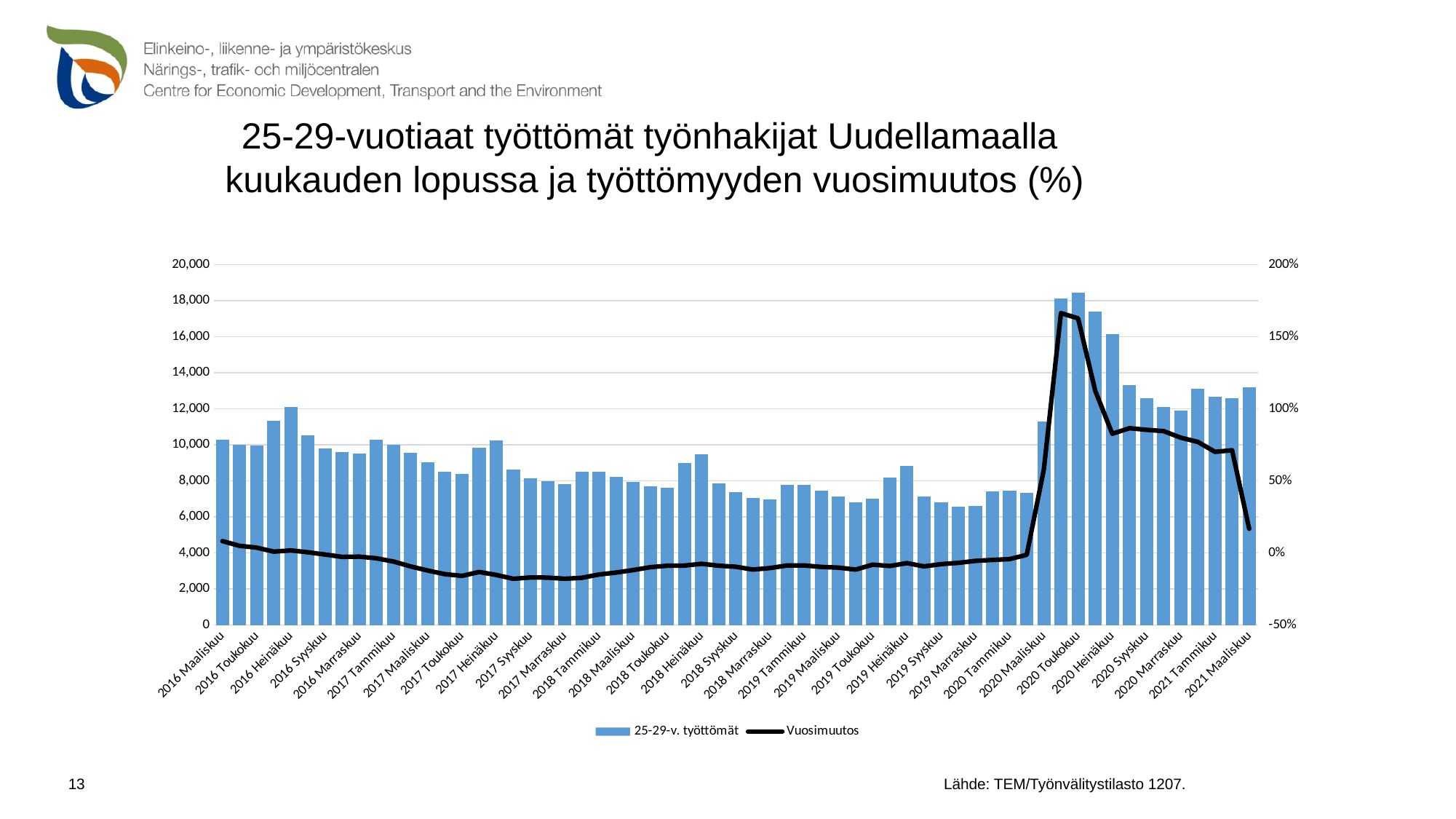
Which has the larger bar value, 2020 Heinäkuu or 2021 Tammikuu? 2020 Heinäkuu Which has the larger bar value, 2016 Heinäkuu or 2019 Heinäkuu? 2016 Heinäkuu What kind of chart is shown on the slide? A combined bar and line chart Is the bar value for 2019 Syyskuu greater or less than 8,000? less Is the bar value for 2020 Toukokuu greater or less than 16,000? greater Is the Vuosimuutos line value for 2020 Toukokuu greater or less than 150%? greater How many series does the legend list? 2 What are the two series named in the legend? 25-29-v. työttömät and Vuosimuutos What is the highest value shown on the left vertical axis? 20,000 Does the Vuosimuutos line rise or fall from 2020 Toukokuu to 2021 Maaliskuu? fall